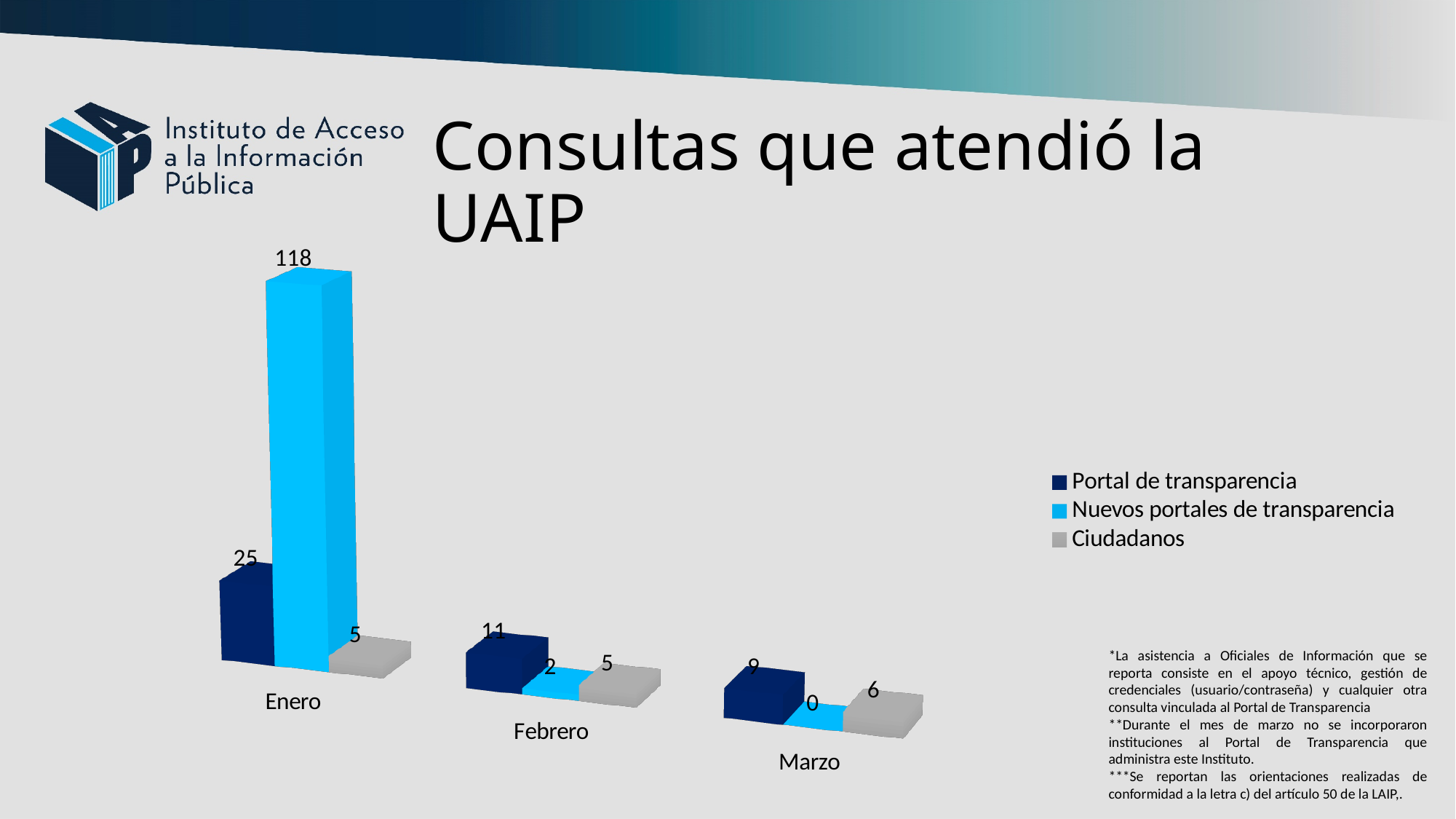
What is the value for Ciudadanos in Marzo? 6 Which month has the lowest value for Nuevos portales de transparencia? Marzo How many series does the legend list? 3 Which is larger: Portal de transparencia in Febrero or Portal de transparencia in Marzo? Portal de transparencia in Febrero Which month has the highest value for Portal de transparencia? Enero Does the value for Portal de transparencia rise or fall from Enero to Marzo? Fall What is the value for Nuevos portales de transparencia in Enero? 118 What is the value for Portal de transparencia in Febrero? 11 What is the value for Nuevos portales de transparencia in Marzo? 0 What kind of chart is shown on the slide? Bar chart What is the difference between the Nuevos portales de transparencia value and the Portal de transparencia value in Enero? 93 How many months are shown on the x axis? 3